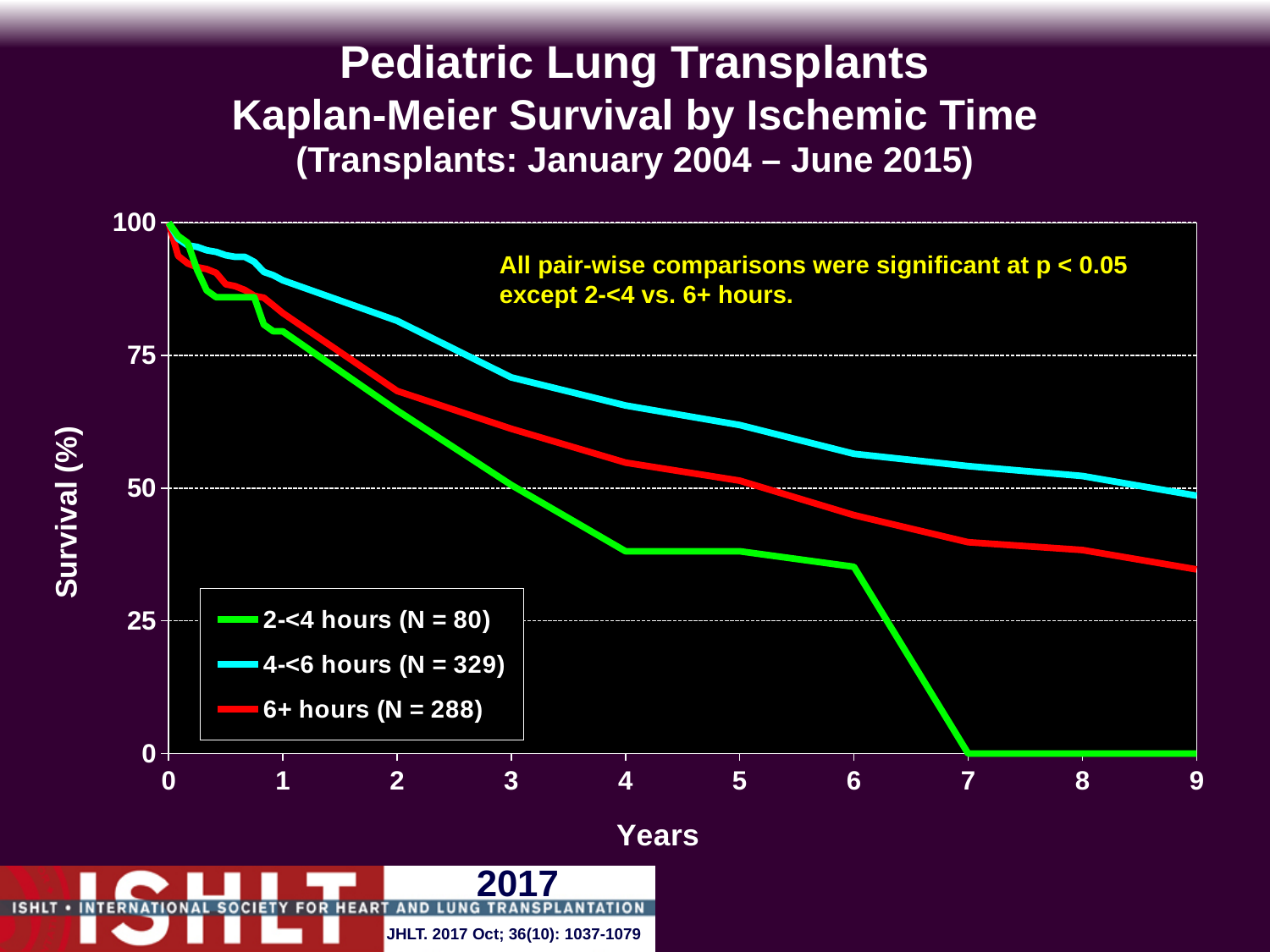
Is the survival for the 2-<4 hours group at year 4 greater or less than 50? less Which ischemic time group has the lowest survival at year 6? 2-<4 hours What is the N for the 4-<6 hours group shown in the legend? 329 What is the label of the y axis? Survival (%) Which ischemic time group has the highest survival at year 5? 4-<6 hours How many series does the legend list? 3 At year 5, which group has higher survival: 4-<6 hours or 6+ hours? 4-<6 hours What is the survival (%) for the 2-<4 hours group at year 8? 0 What kind of chart is shown on the slide? Line chart Is the survival for the 6+ hours group at year 9 greater or less than 50? less Do the survival curves rise or fall as years increase? fall Is the survival for the 4-<6 hours group at year 3 greater or less than 75? less